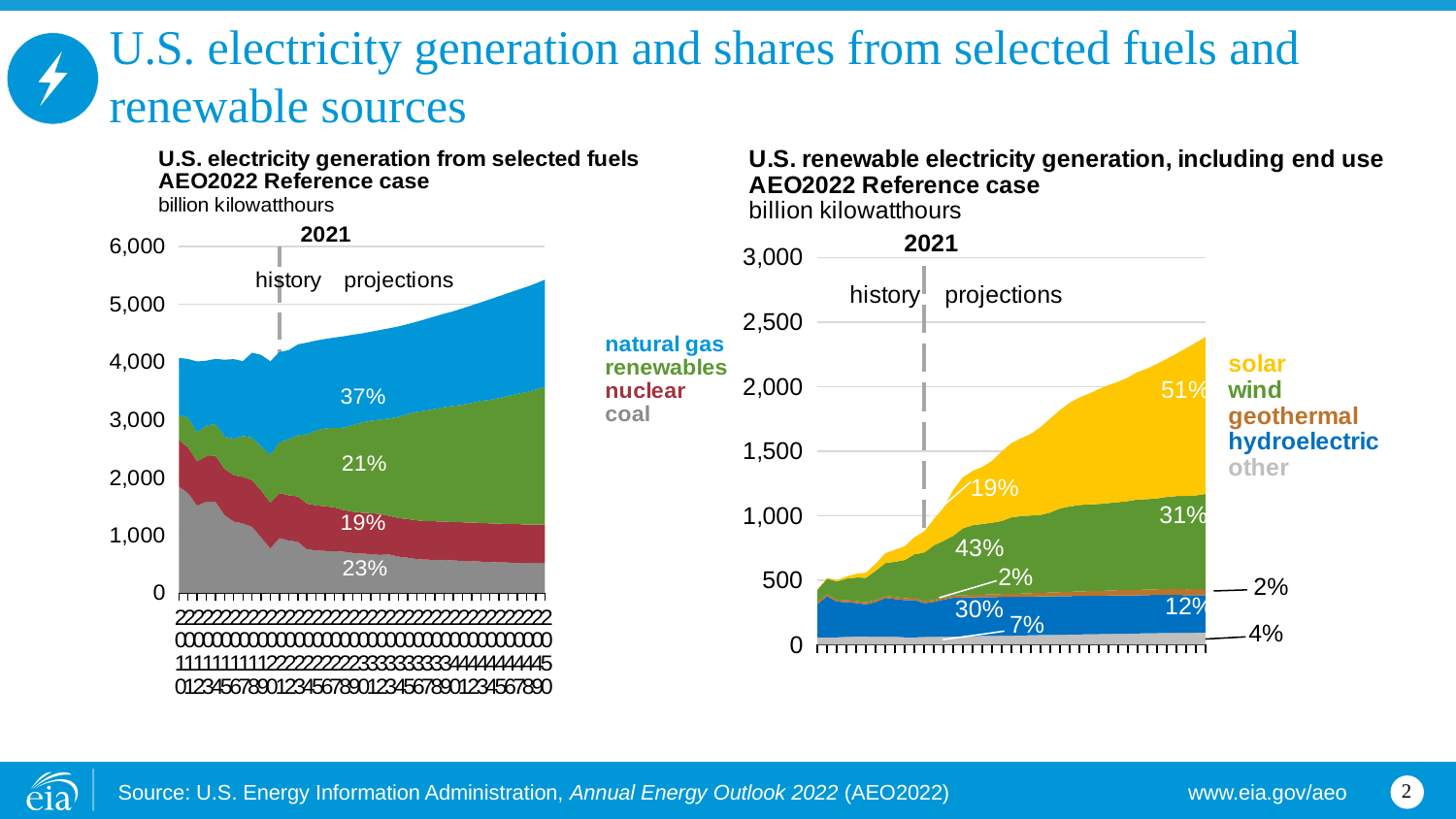
In the right chart, 'U.S. renewable electricity generation, including end use', what share is labeled for wind at the end of the projection period? 31% In the left chart, 'U.S. electricity generation from selected fuels', is total generation at the end of the projection period greater or less than 5,000 billion kilowatthours? greater What kind of chart is the left chart, 'U.S. electricity generation from selected fuels'? stacked area chart In the right chart, 'U.S. renewable electricity generation, including end use', is total renewable generation at the end of the projection period greater or less than 2,000 billion kilowatthours? greater In the right chart, 'U.S. renewable electricity generation, including end use', what share is labeled for solar at the end of the projection period? 51% In the right chart, 'U.S. renewable electricity generation, including end use', does total renewable generation rise or fall over the projection period? rise In the right chart, 'U.S. renewable electricity generation, including end use', which source has the smallest labeled share at the end of the projection period? geothermal How many sources does the legend of the right chart, 'U.S. renewable electricity generation, including end use', list? 5 In the left chart, 'U.S. electricity generation from selected fuels', what is the difference between the labeled shares for natural gas (37%) and renewables (21%)? 16%